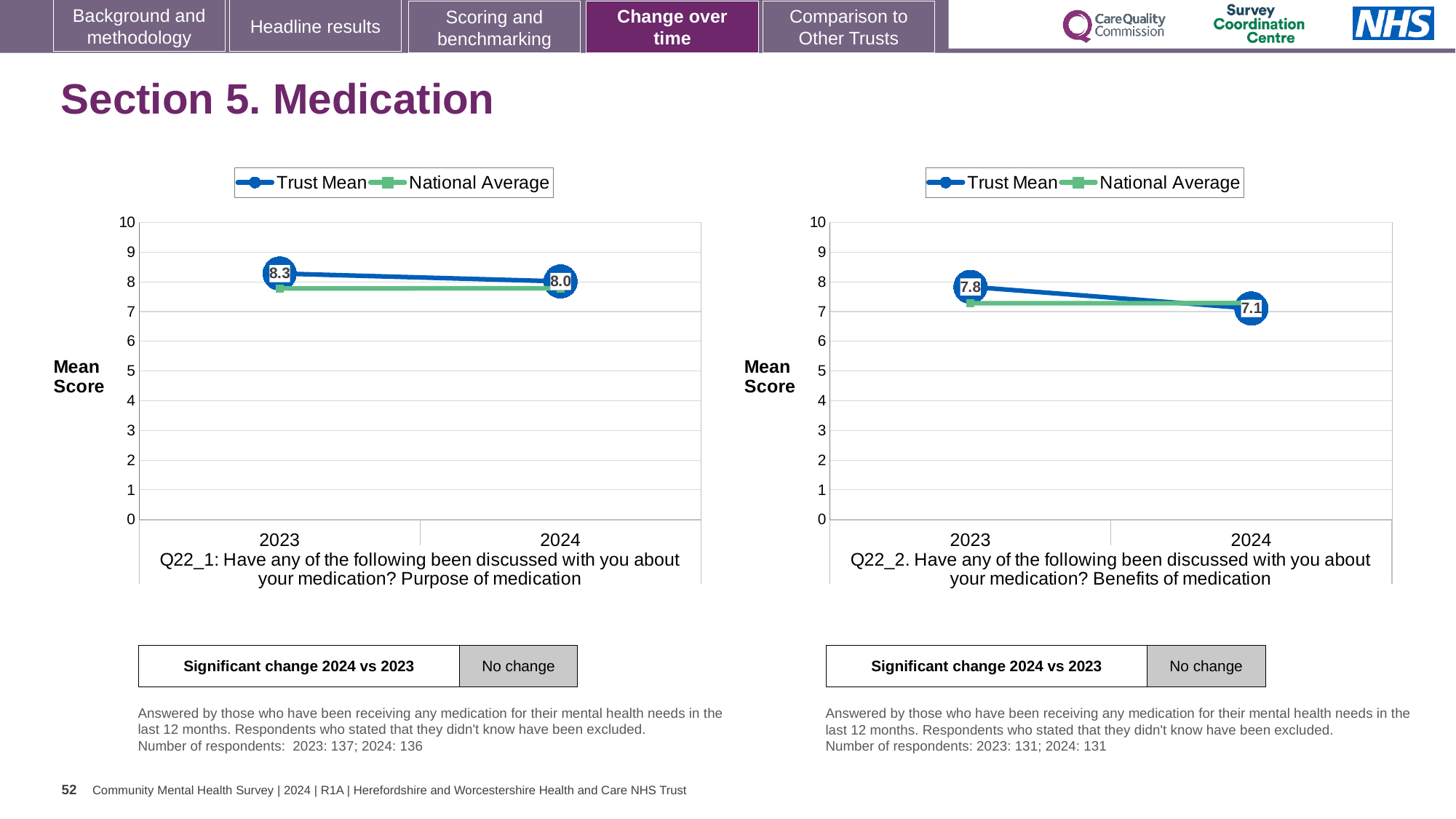
In the right chart (Q22_2: Benefits of medication), is the National Average for 2024 greater or less than 7? greater In the right chart (Q22_2: Benefits of medication), what is the Trust Mean for 2024? 7.1 In the left chart (Q22_1: Purpose of medication), which year has the higher Trust Mean, 2023 or 2024? 2023 In the right chart (Q22_2: Benefits of medication), what is the Trust Mean for 2023? 7.8 In the right chart (Q22_2: Benefits of medication), what is the difference between the Trust Mean in 2023 and in 2024? 0.7 What kind of chart is the left chart (Q22_1: Purpose of medication)? line chart In the left chart (Q22_1: Purpose of medication), what is the Trust Mean for 2024? 8.0 In the left chart (Q22_1: Purpose of medication), is the National Average for 2023 greater or less than 8? less In the left chart (Q22_1: Purpose of medication), by how much did the Trust Mean fall from 2023 to 2024? 0.3 In the left chart (Q22_1: Purpose of medication), what is the Trust Mean for 2023? 8.3 In the right chart (Q22_2: Benefits of medication), does the Trust Mean rise or fall from 2023 to 2024? fall How many series does the legend of the right chart (Q22_2: Benefits of medication) list? 2